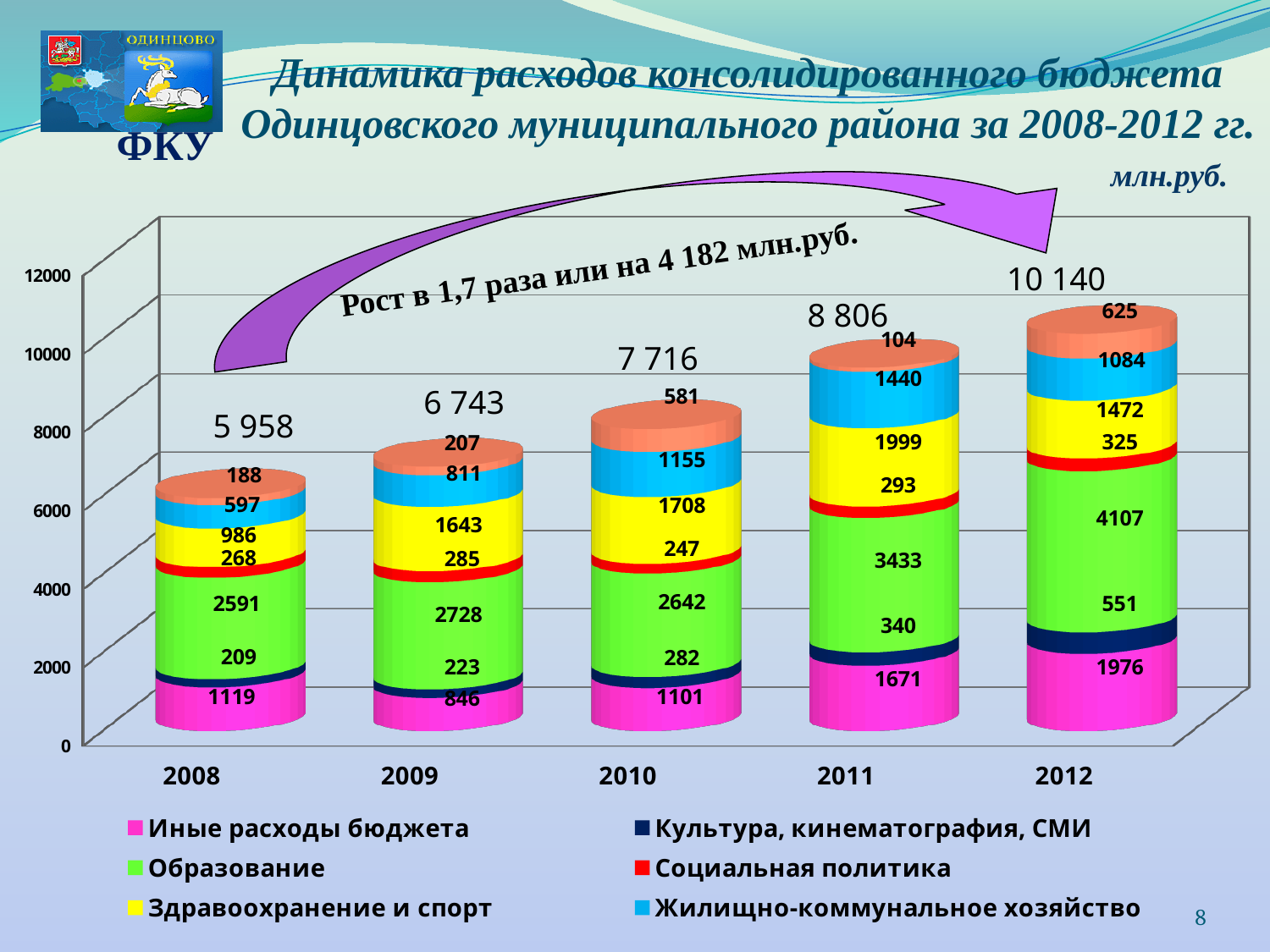
What is the value for Жилищно-коммунальное хозяйство in 2010? 1155 By how much did the value for Образование increase from 2011 to 2012? 674 What kind of chart is shown on the slide? bar chart Which year has the larger value for Здравоохранение и спорт, 2011 or 2012? 2011 What is the difference between the total expenditure in 2012 and in 2008? 4 182 Which year has the highest total expenditure? 2012 Which year has the lowest total expenditure? 2008 What is the total consolidated budget expenditure shown for 2010? 7 716 How many series does the chart legend list? 6 Do the total expenditures rise or fall from 2008 to 2012? rise How many years are shown on the x axis of the chart? 5 What is the value for Образование in 2012? 4107